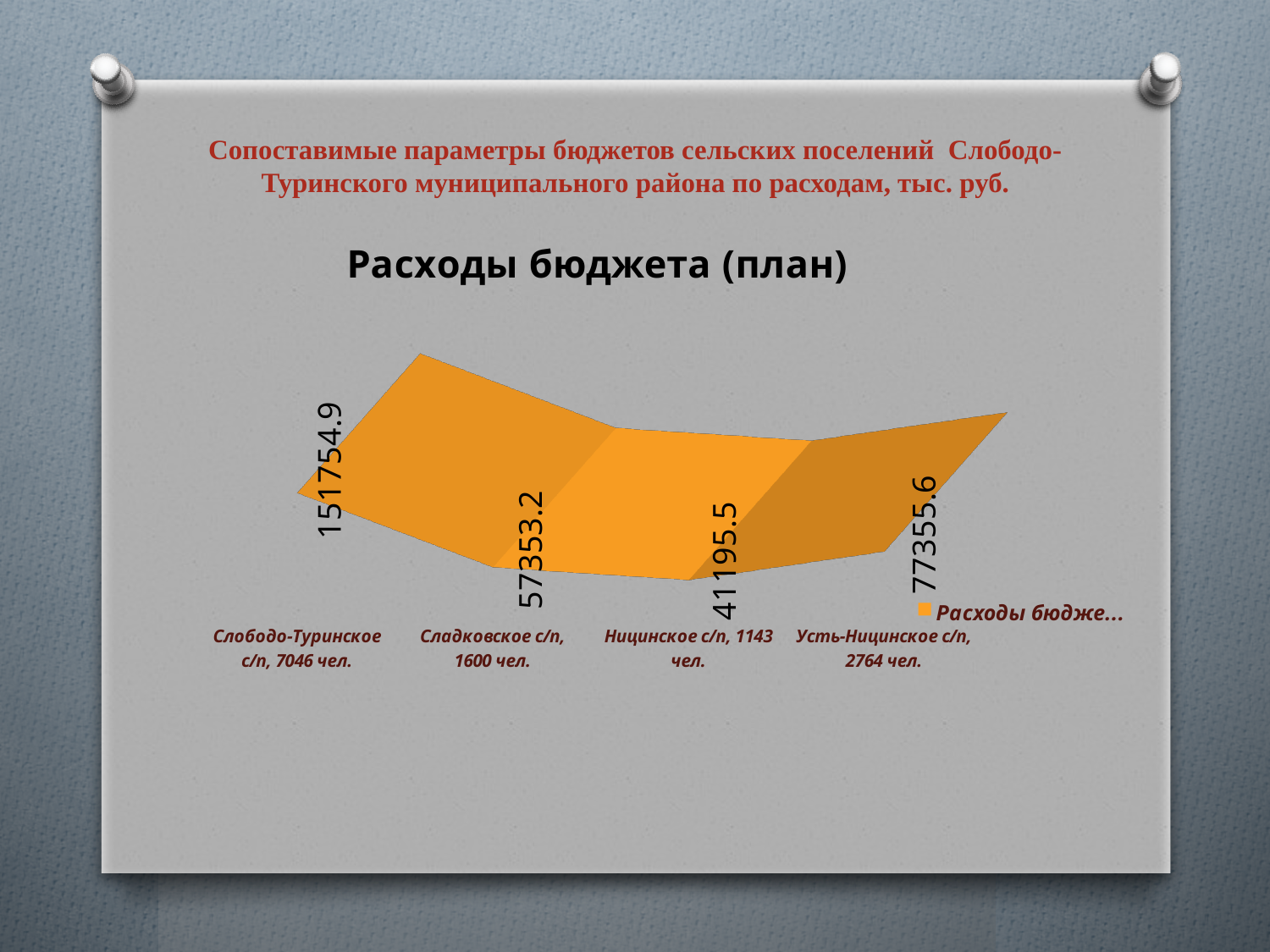
What is the difference between the values for Усть-Ницинское с/п and Ницинское с/п? 36160.1 What is the planned budget expenditure value shown for Слободо-Туринское с/п? 151754.9 What is the title of the chart? Расходы бюджета (план) What value is shown for Сладковское с/п in the chart? 57353.2 How many settlements (categories) are plotted in the chart? 4 Which settlement has the highest planned budget expenditure? Слободо-Туринское с/п Which is larger, the value for Сладковское с/п or the value for Усть-Ницинское с/п? Усть-Ницинское с/п What value is shown for Ницинское с/п in the chart? 41195.5 What value is shown for Усть-Ницинское с/п in the chart? 77355.6 What is the difference between the values for Слободо-Туринское с/п and Сладковское с/п? 94401.7 What kind of chart is shown on the slide? 3D line chart Which settlement has the lowest planned budget expenditure? Ницинское с/п